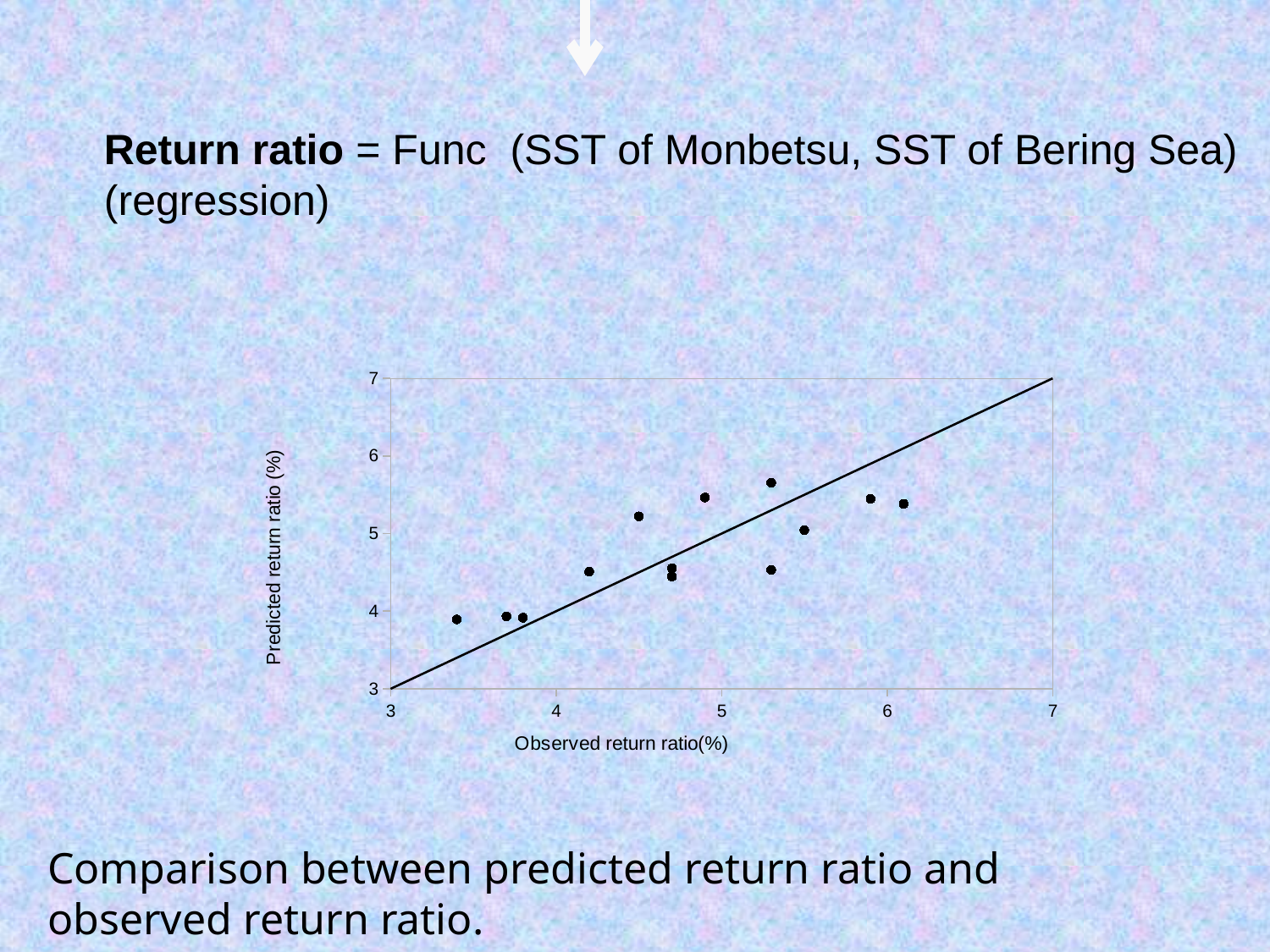
What is the maximum value shown on the x axis? 7 Is the highest predicted return ratio plotted greater or less than 6? less Do the predicted return ratios generally rise or fall as the observed return ratio increases? rise Is the lowest predicted return ratio plotted greater or less than 4? less Is the predicted return ratio for the point with the largest observed return ratio greater or less than 5? greater What kind of chart is shown on the slide? scatter plot What is the label of the x axis of the chart? Observed return ratio(%) What is the label of the y axis of the chart? Predicted return ratio (%)